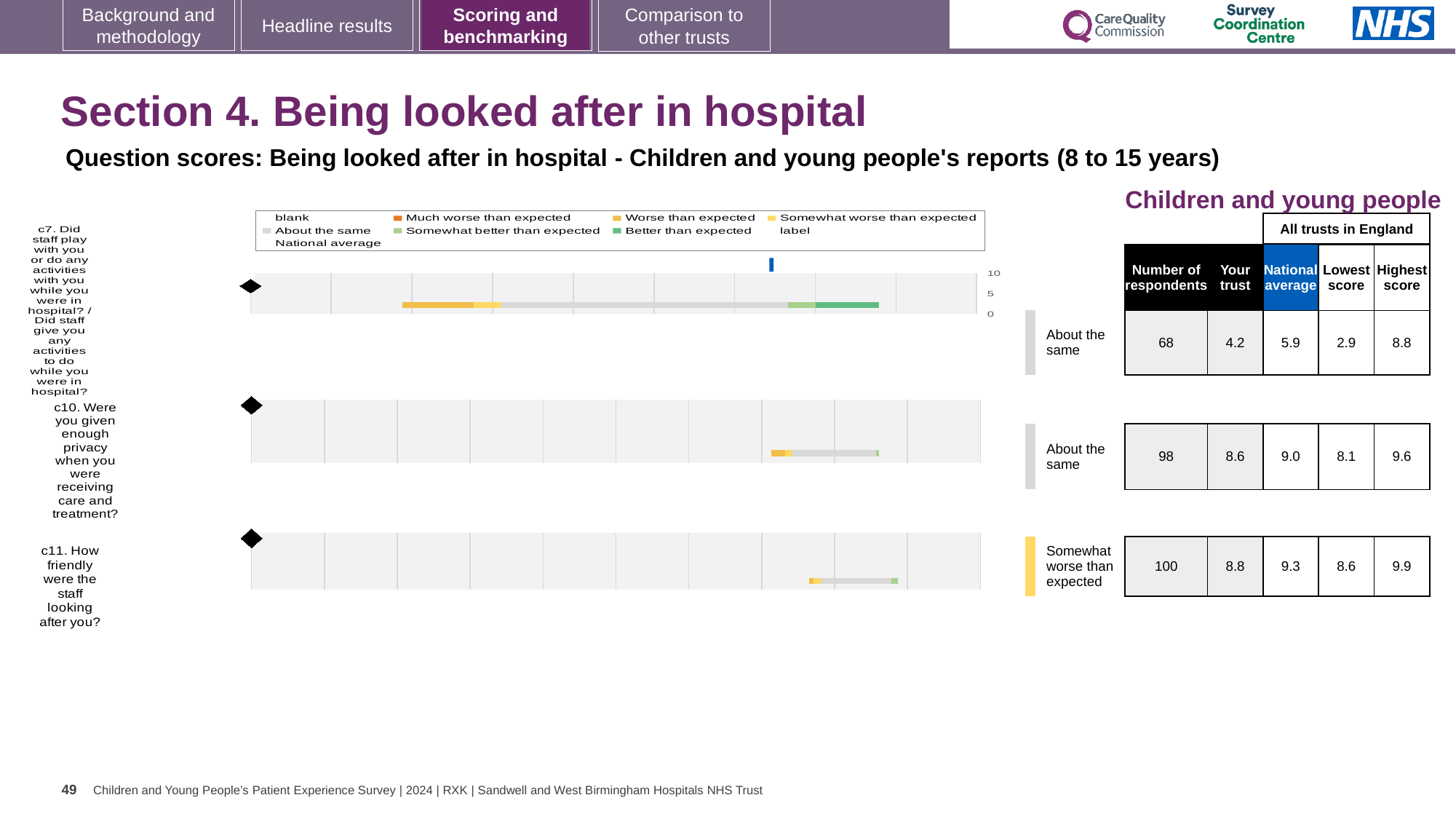
What is the 'Your trust' score for question c7 (Did staff play with you or do any activities with you while you were in hospital?)? 4.2 How many respondents answered question c11 (How friendly were the staff looking after you?)? 100 Which question has the highest 'Your trust' score? c11. How friendly were the staff looking after you? What kind of chart is used to show the question scores on this slide? bar chart What is the highest score among all trusts in England for question c10? 9.6 For question c10, which is larger: the trust's score or the national average? National average Is the trust's score for question c7 greater or less than 5? less What is the national average score for question c10 (Were you given enough privacy when you were receiving care and treatment?)? 9.0 Which question has the lowest 'Your trust' score? c7. Did staff play with you or do any activities with you while you were in hospital? For question c7, how much higher is the national average than the trust's score? 1.7 What benchmark category is question c11 assigned to? Somewhat worse than expected How many questions are plotted on this slide? 3